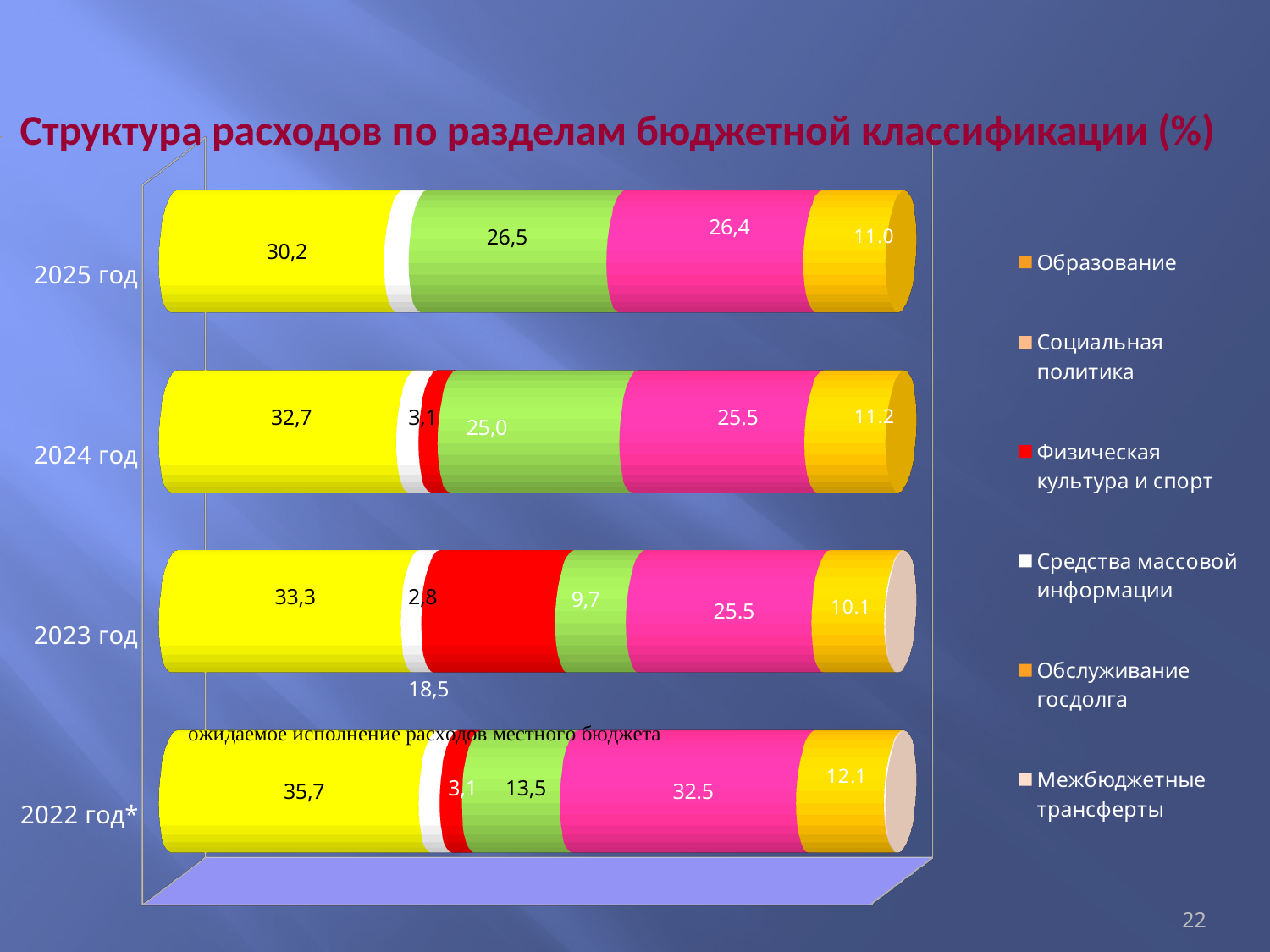
What is the value of the rightmost (gold) segment for 2024 год? 11.2 What kind of chart is shown on the slide? Stacked bar chart What is the title of the chart? Структура расходов по разделам бюджетной классификации (%) What is the value of the yellow (leftmost) segment for 2022 год*? 35,7 Which year has the largest yellow (leftmost) segment? 2022 год* What is the value of the yellow (leftmost) segment for 2025 год? 30,2 How many series does the legend list? 6 What is the value of the red segment in the 2023 год bar? 18,5 What is the difference between the yellow segment values for 2022 год* and 2025 год? 5,5 How many years (categories) are shown on the chart? 4 Which year has the smallest rightmost (gold) segment? 2023 год What is the value of the pink segment in the 2022 год* bar? 32.5